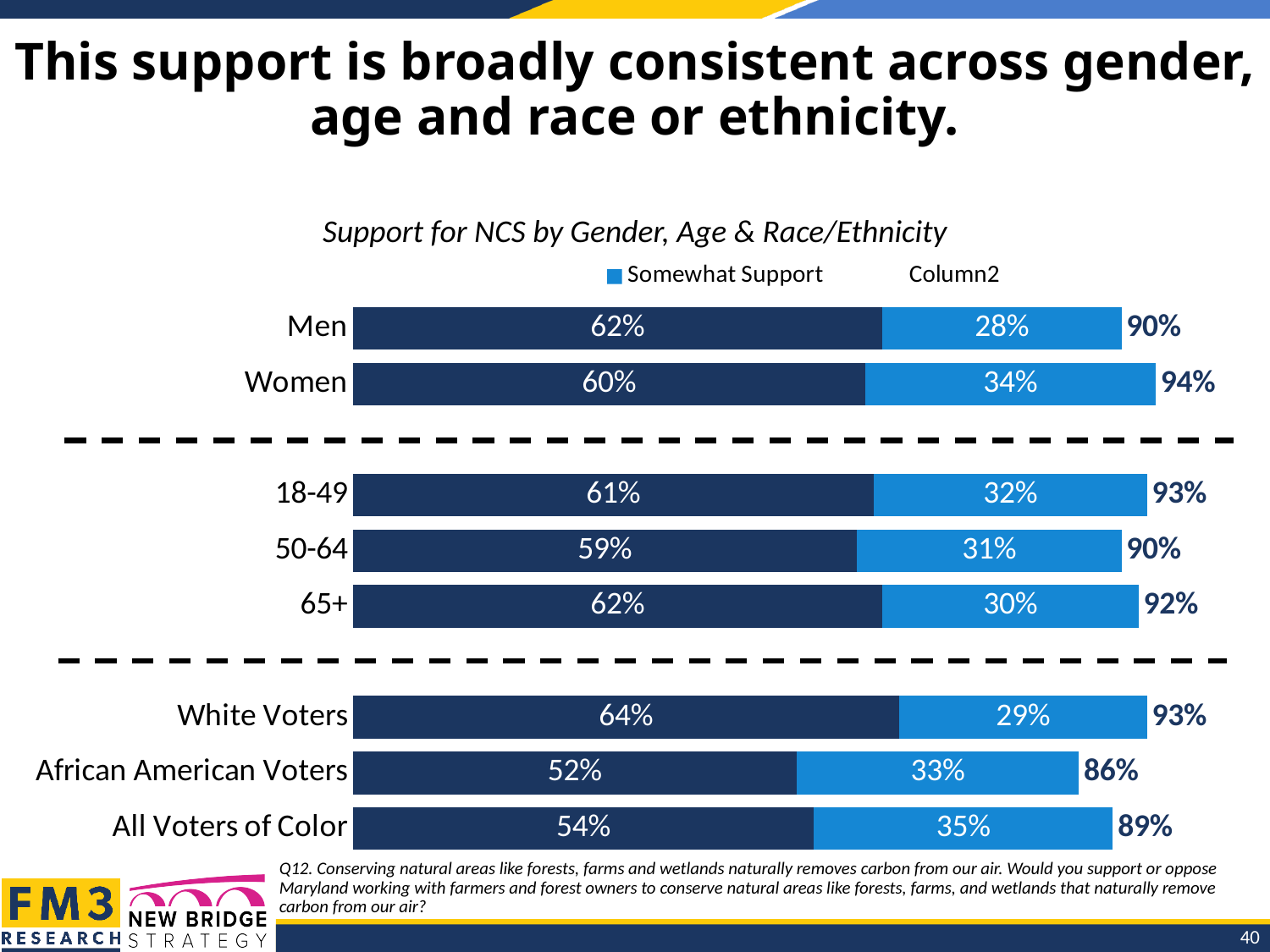
How many series does the legend list? 2 How many categories (bars) does the chart show? 8 What is the value of the light blue segment for the 50-64 age group? 31% Which category has the highest total support? Women What is the difference between the total support for Women and for Men? 4% What is the total support shown at the end of the bar for Women? 94% What is the title of the chart? Support for NCS by Gender, Age & Race/Ethnicity Which category has the lowest total support? African American Voters What kind of chart is shown on the slide? bar chart What is the value of the dark blue segment for White Voters? 64% Which has the larger dark blue segment, White Voters or African American Voters? White Voters What is the value of the light blue segment for All Voters of Color? 35%